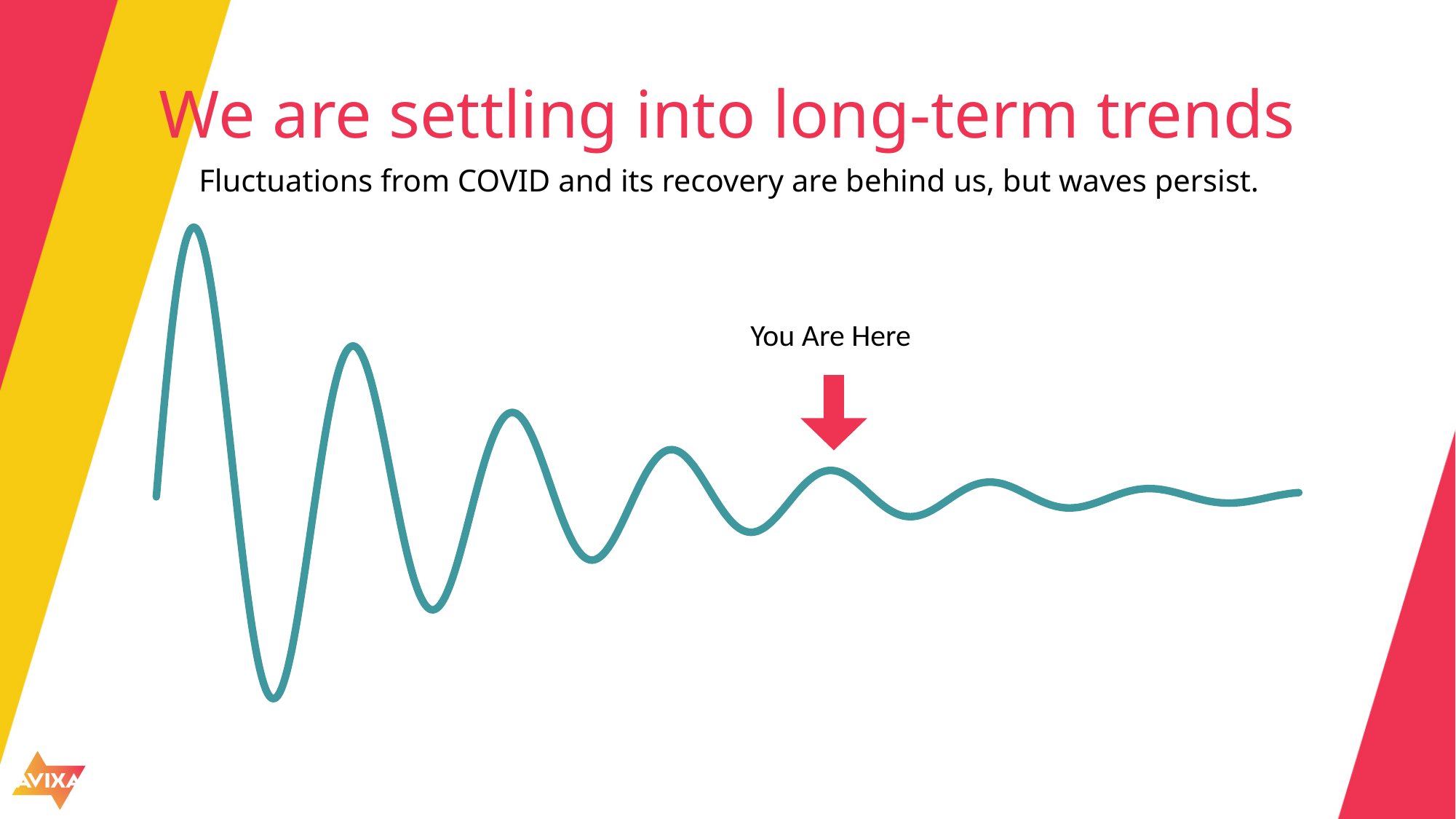
Where along the line is the highest peak located? At the far left (the first peak) What is the title of the slide containing the chart? We are settling into long-term trends How many lines are plotted on the chart? 1 How do the swings of the line change as it moves from left to right? They get smaller (the waves dampen) Which peak of the line is the highest, the leftmost one or the rightmost one? The leftmost one What does the label above the red arrow pointing at the line say? You Are Here What kind of chart is shown on the slide? Line chart Where along the line is the lowest trough located? At the far left (the first trough)